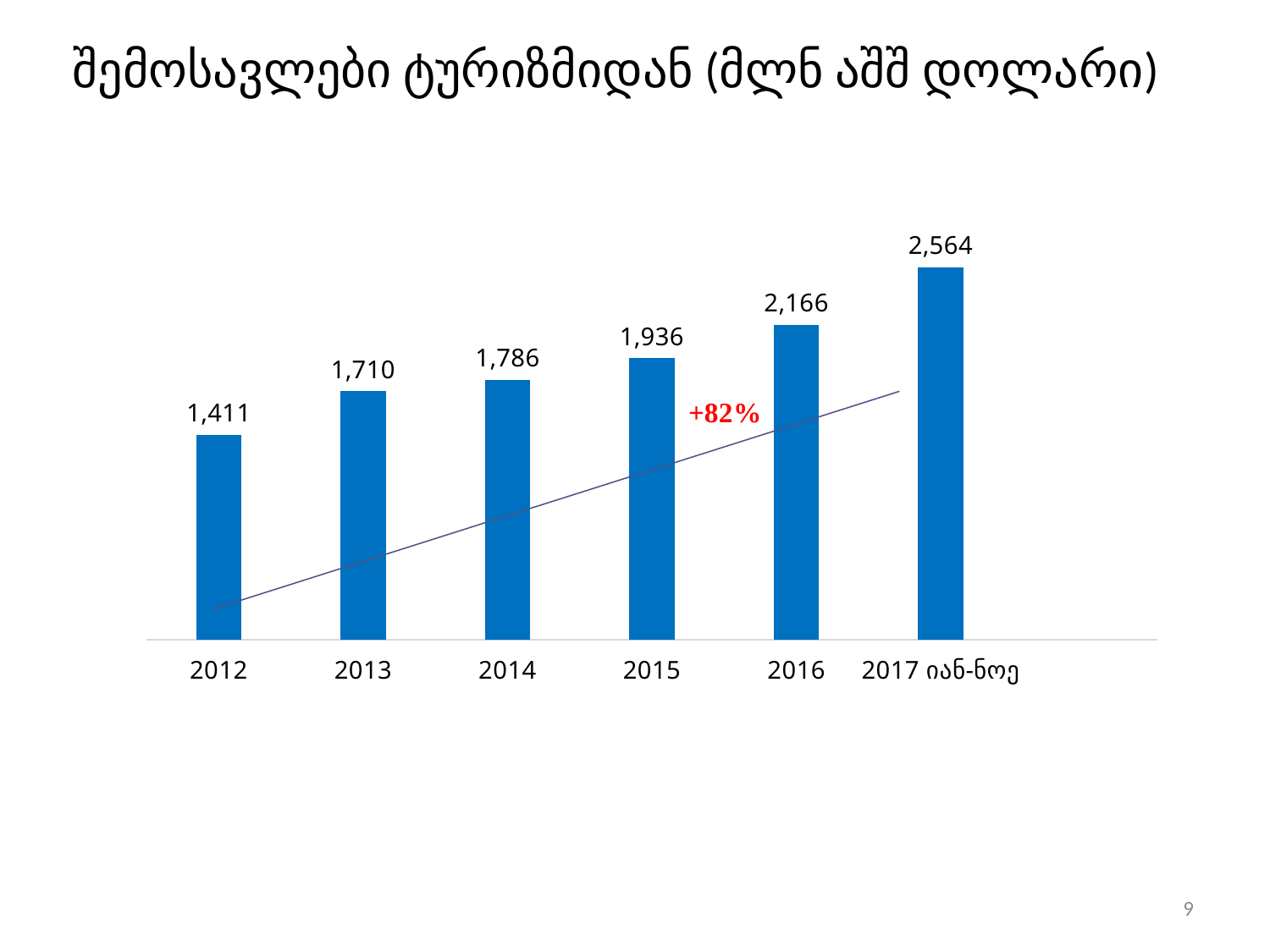
What is the value for 2015? 1,936 Which category has the lowest value? 2012 How many bars are shown in the chart? 6 What is the value for 2012? 1,411 What is the difference between the values for 2017 იან-ნოე and 2012? 1,153 What is the difference between the values for 2016 and 2015? 230 Which is larger, the value for 2014 or the value for 2013? 2014 Do the values rise or fall from 2012 to 2017 იან-ნოე? Rise Which category has the highest value? 2017 იან-ნოე What is the value for 2017 იან-ნოე? 2,564 What kind of chart is shown on the slide? Bar chart What percentage change is annotated in red on the chart? +82%